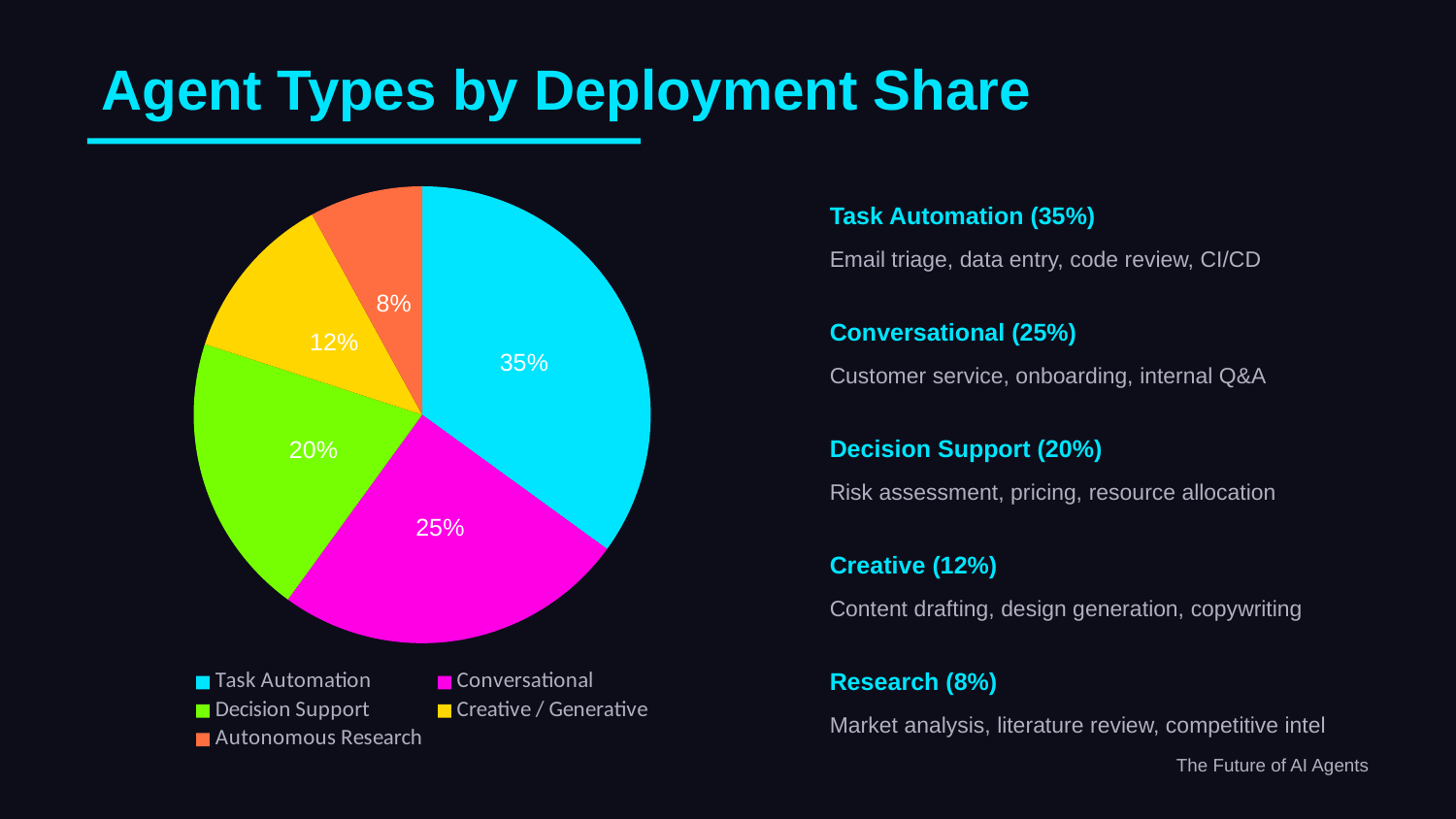
What share does Task Automation have in the pie chart? 35% What share does Decision Support have in the pie chart? 20% What is the difference between the Conversational and Creative / Generative shares? 13% What type of chart is shown on the slide? pie chart What is the combined share of Task Automation and Conversational? 60% Which is larger, the Decision Support slice or the Creative / Generative slice? Decision Support Which legend entry is shown in magenta? Conversational What share does Autonomous Research have in the pie chart? 8% Which category has the smallest slice of the pie chart? Autonomous Research How many categories does the pie chart show? 5 What is the title of the chart? Agent Types by Deployment Share Which category has the largest slice of the pie chart? Task Automation